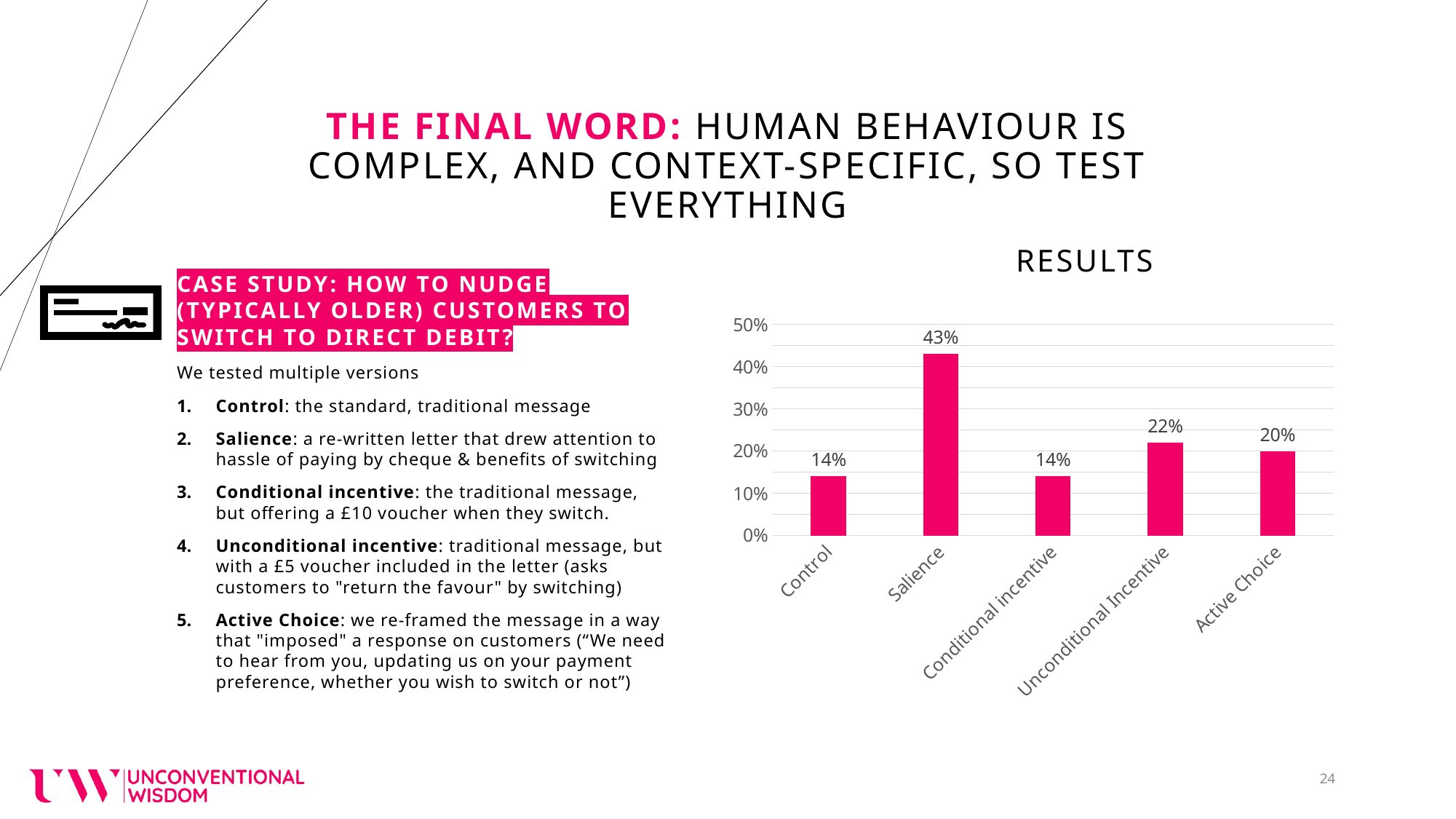
What is the value for Control in the Results chart? 14% Which is larger in the Results chart, Unconditional Incentive or Conditional incentive? Unconditional Incentive What is the value for Unconditional Incentive in the Results chart? 22% What kind of chart is the Results chart? Bar chart What is the value for Active Choice in the Results chart? 20% What is the difference between the Unconditional Incentive and Active Choice values in the Results chart? 2% What is the value for Salience in the Results chart? 43% Which category has the highest value in the Results chart? Salience What is the difference between the Salience and Control values in the Results chart? 29% How many categories are shown in the Results chart? 5 What is the title of the chart on the slide? RESULTS Is the value for Salience in the Results chart greater or less than 40%? greater